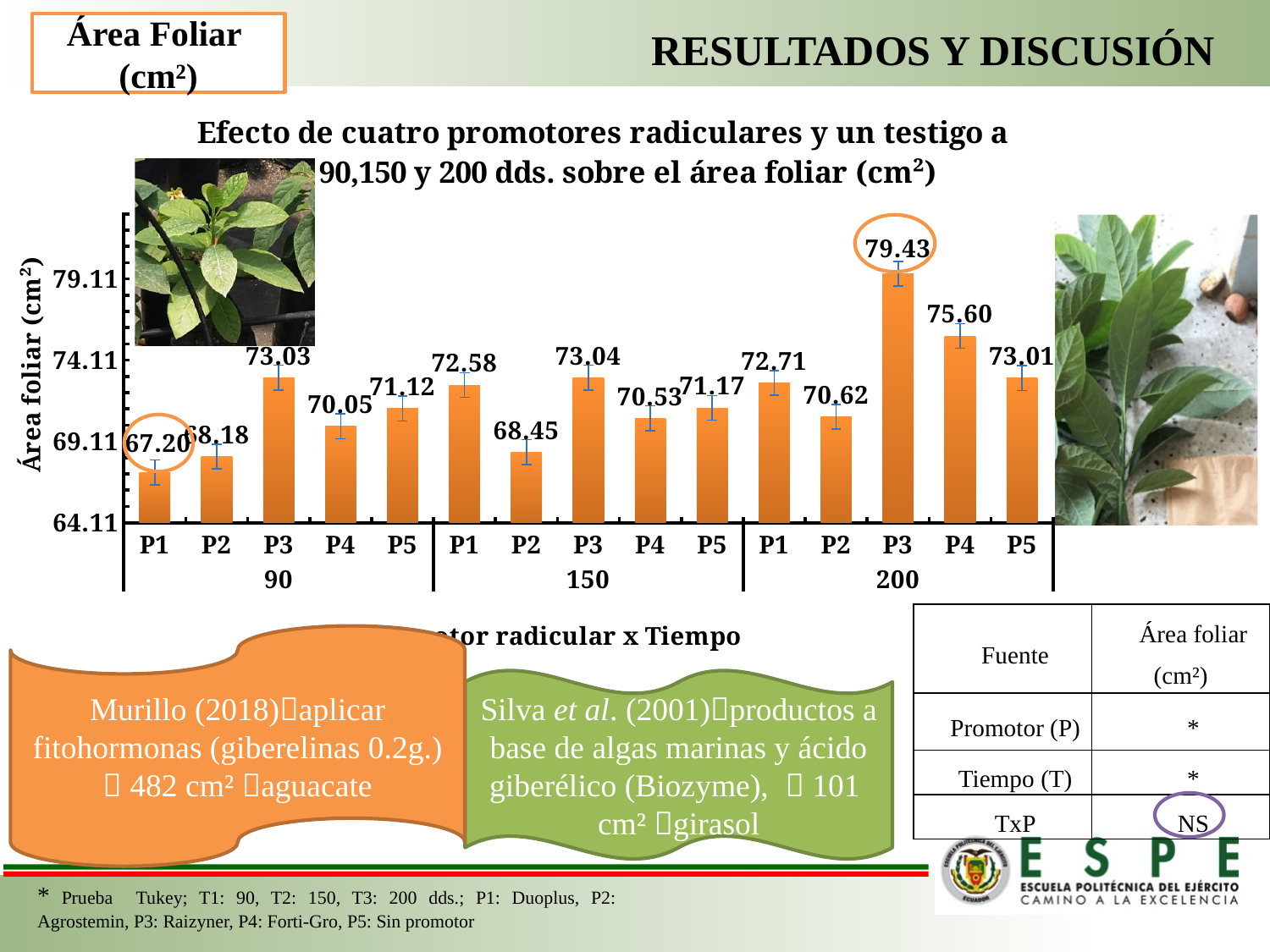
What is the leaf area value for P3 at 200 dds? 79.43 Within the 200 dds group, does the leaf area rise or fall from P2 to P3? Rise What is the difference between the leaf area of P3 at 200 dds and P4 at 200 dds? 3.83 What is the leaf area value for P2 at 150 dds? 68.45 What is the leaf area value for P4 at 200 dds? 75.60 What is the leaf area value for P1 at 90 dds? 67.20 How many bars are plotted in the chart? 15 Which bar has the highest leaf area value in the chart? P3 at 200 dds What is the label of the vertical axis of the chart? Área foliar (cm²) Which is larger, the leaf area of P1 at 150 dds or P1 at 90 dds? P1 at 150 dds What type of chart is shown on the slide? Bar chart Which bar has the lowest leaf area value in the chart? P1 at 90 dds